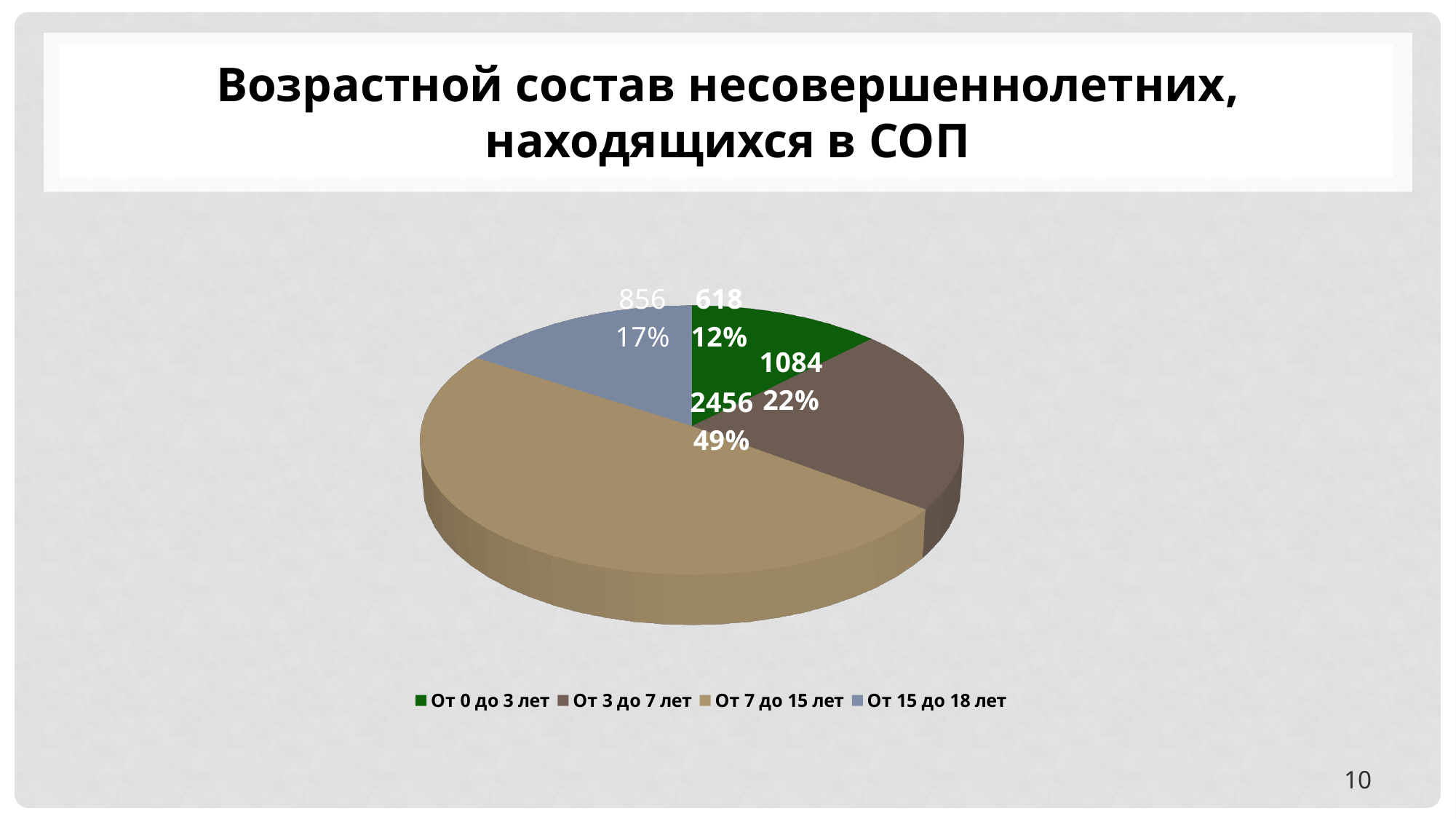
Which is larger, the value for "От 15 до 18 лет" or the value for "От 3 до 7 лет"? От 3 до 7 лет What kind of chart is shown on the slide? pie chart What is the value for the category "От 0 до 3 лет"? 618 How many categories does the pie chart have? 4 What is the value for the category "От 7 до 15 лет"? 2456 What is the title of the chart on the slide? Возрастной состав несовершеннолетних, находящихся в СОП Which category has the largest slice? От 7 до 15 лет What is the value for the category "От 15 до 18 лет"? 856 What percentage share does the slice "От 3 до 7 лет" have? 22% Which category has the smallest slice? От 0 до 3 лет What percentage share does the slice "От 7 до 15 лет" have? 49% What is the difference between the values for "От 7 до 15 лет" and "От 3 до 7 лет"? 1372